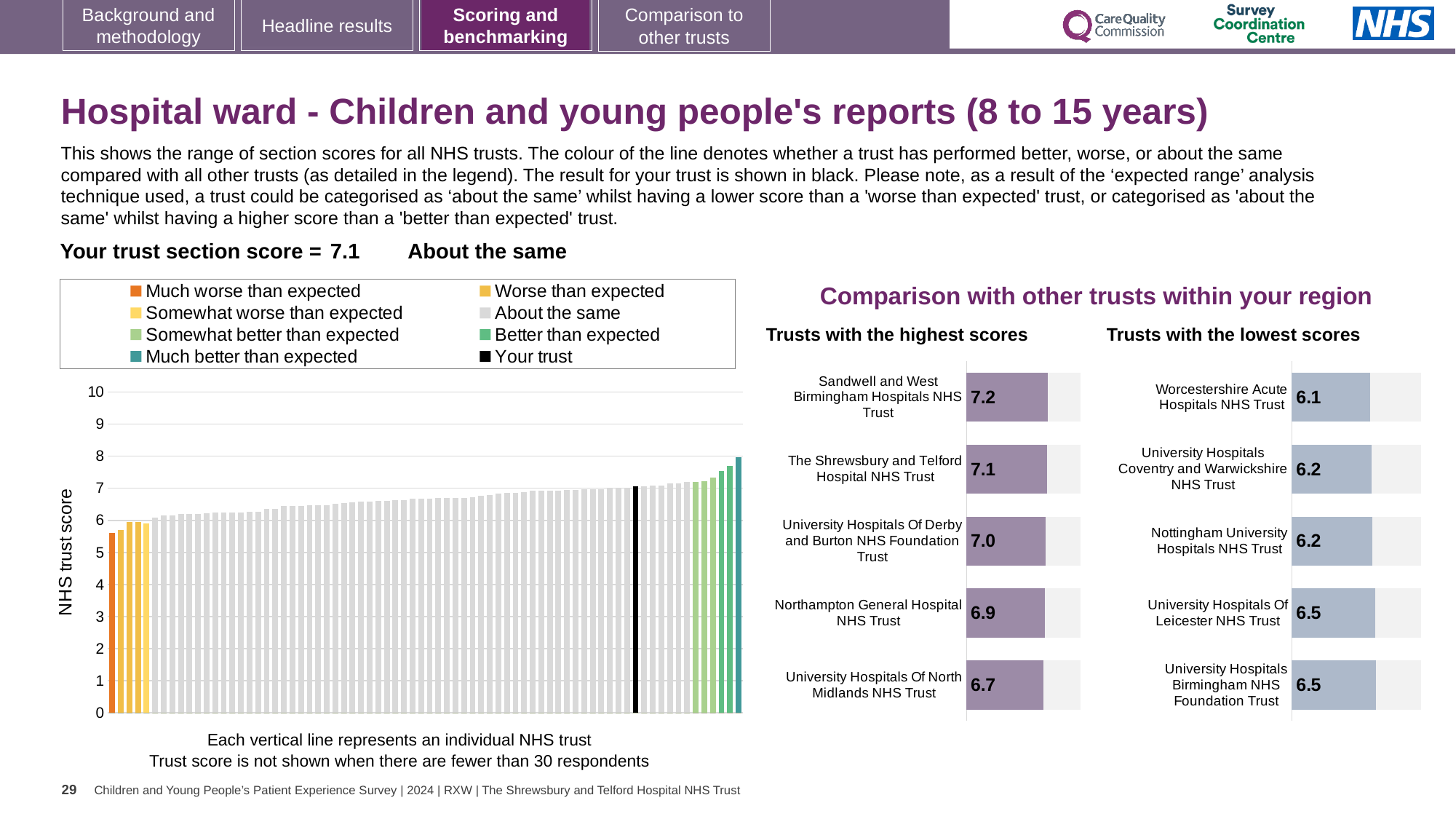
In the 'Trusts with the lowest scores' chart, what is the score for Worcestershire Acute Hospitals NHS Trust? 6.1 In the 'Trusts with the lowest scores' chart, what is the score for University Hospitals Of Leicester NHS Trust? 6.5 In the 'Trusts with the lowest scores' chart, which trust has the lowest score? Worcestershire Acute Hospitals NHS Trust What kind of chart is the main 'NHS trust score' chart on the left? bar chart How many trusts are listed in the 'Trusts with the highest scores' chart? 5 In the 'Trusts with the lowest scores' chart, which has the larger score: Nottingham University Hospitals NHS Trust or University Hospitals Birmingham NHS Foundation Trust? University Hospitals Birmingham NHS Foundation Trust In the 'Trusts with the highest scores' chart, which trust has the highest score? Sandwell and West Birmingham Hospitals NHS Trust In the 'Trusts with the highest scores' chart, what is the difference between the scores of Sandwell and West Birmingham Hospitals NHS Trust and University Hospitals Of North Midlands NHS Trust? 0.5 How many entries does the legend of the main 'NHS trust score' chart list? 8 In the 'Trusts with the highest scores' chart, what is the score for Sandwell and West Birmingham Hospitals NHS Trust? 7.2 In the main 'NHS trust score' chart on the left, is the value of the lowest (leftmost) bar greater or less than 6? less In the 'Trusts with the highest scores' chart, what is the score for University Hospitals Of North Midlands NHS Trust? 6.7